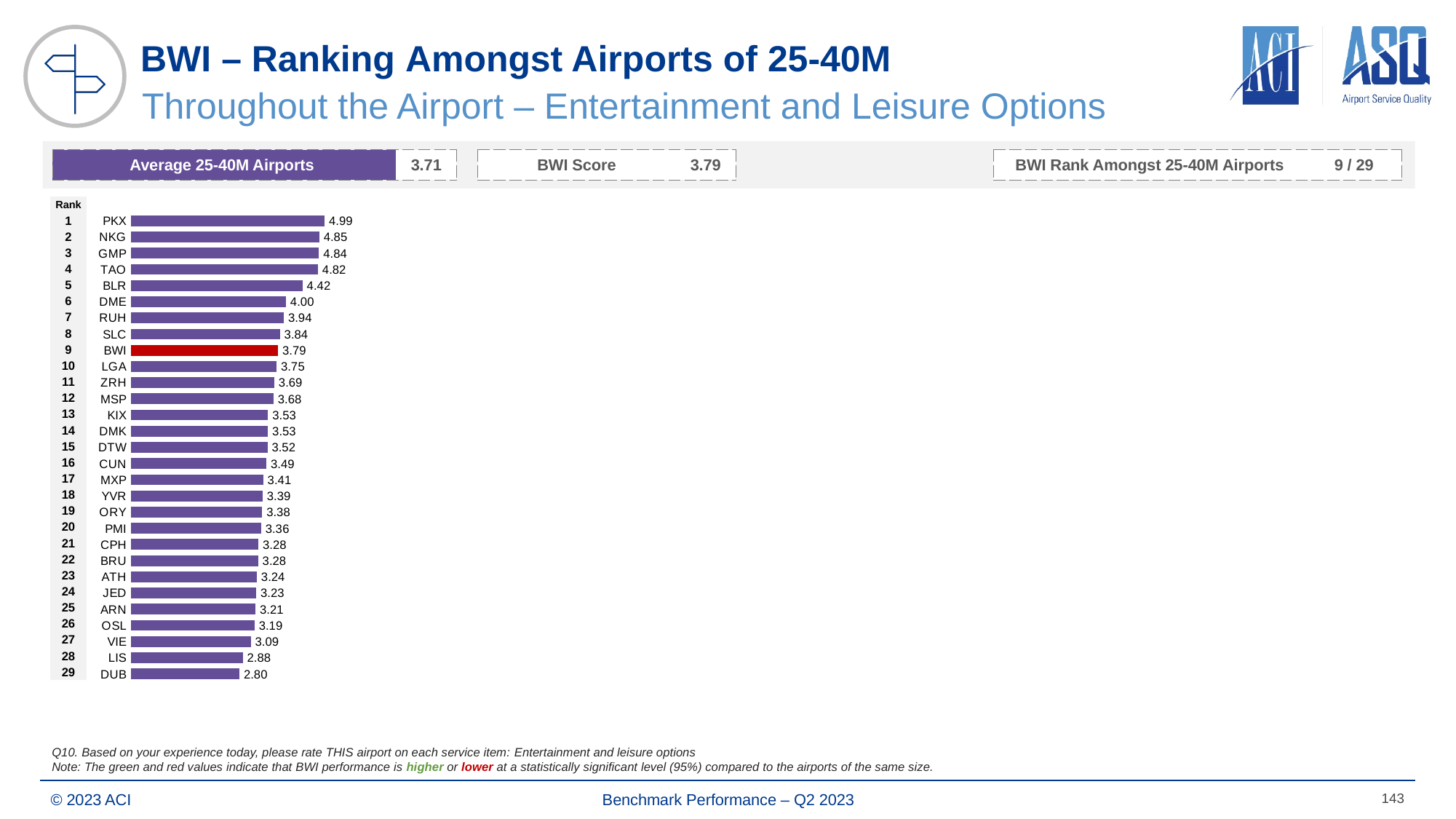
Which airport has the highest score? PKX What kind of chart is shown on the slide? Bar chart What is the difference between the BWI score and the average for 25-40M airports? 0.08 Which airport has the lowest score? DUB What is BWI's rank amongst 25-40M airports? 9 / 29 What is the score for DUB? 2.80 Which bar is highlighted in red? BWI What is the difference between the scores of PKX and DUB? 2.19 Which has a higher score, SLC or LGA? SLC How many airports are ranked in the chart? 29 What is the score for PKX? 4.99 What is the score for BWI? 3.79